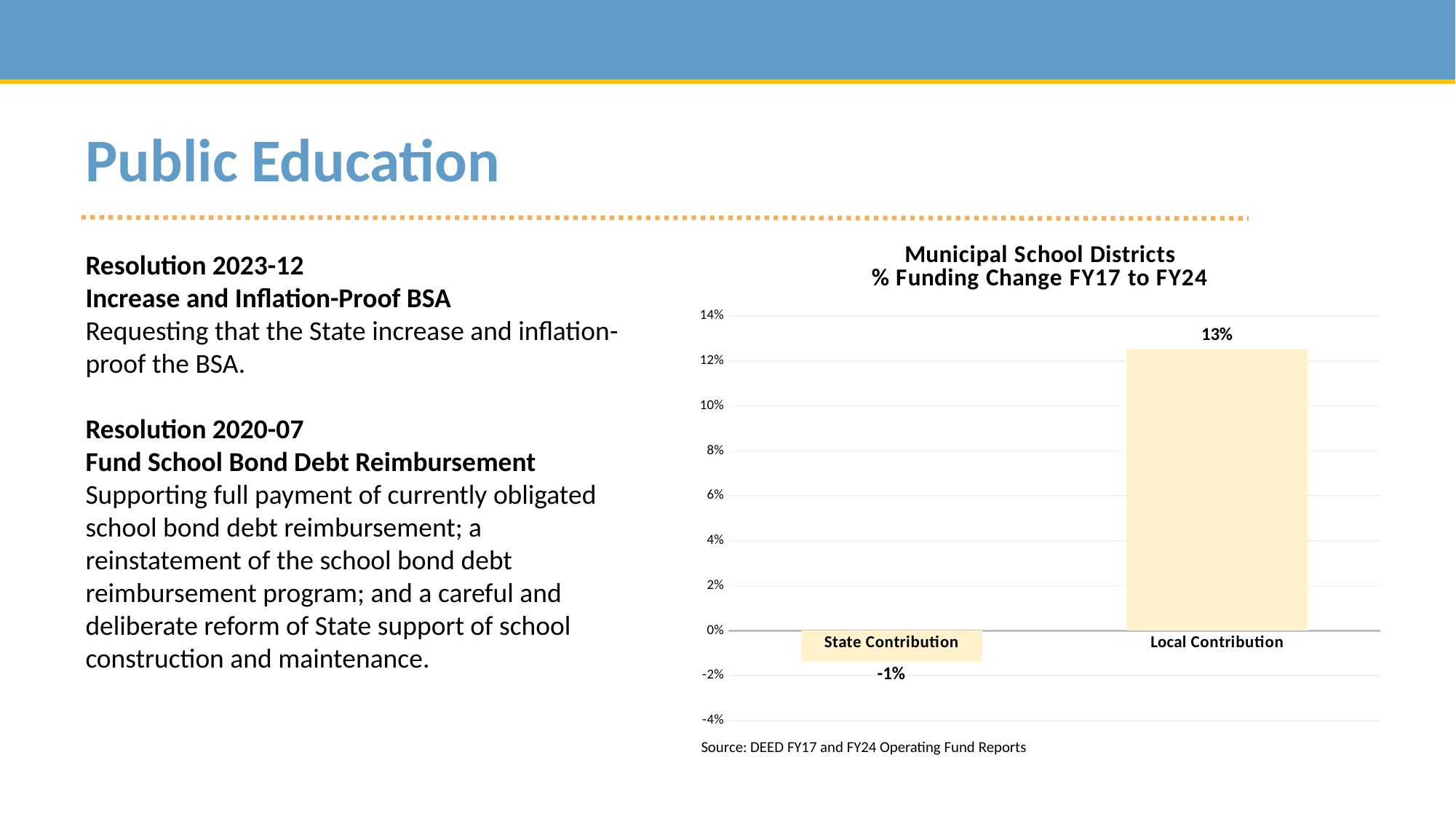
What is the difference between the Local Contribution and State Contribution values? 14 percentage points What is the value for State Contribution? -1% What is the value for Local Contribution? 13% Which category has the lowest value? State Contribution Is the value for State Contribution greater or less than 0%? less Which category has the highest value? Local Contribution What source is cited below the chart? DEED FY17 and FY24 Operating Fund Reports What kind of chart is shown on the slide? Bar chart What is the title of the chart? Municipal School Districts % Funding Change FY17 to FY24 How many categories are shown in the chart? 2 Which is larger, the value for State Contribution or the value for Local Contribution? Local Contribution Is the value for Local Contribution greater or less than 10%? greater